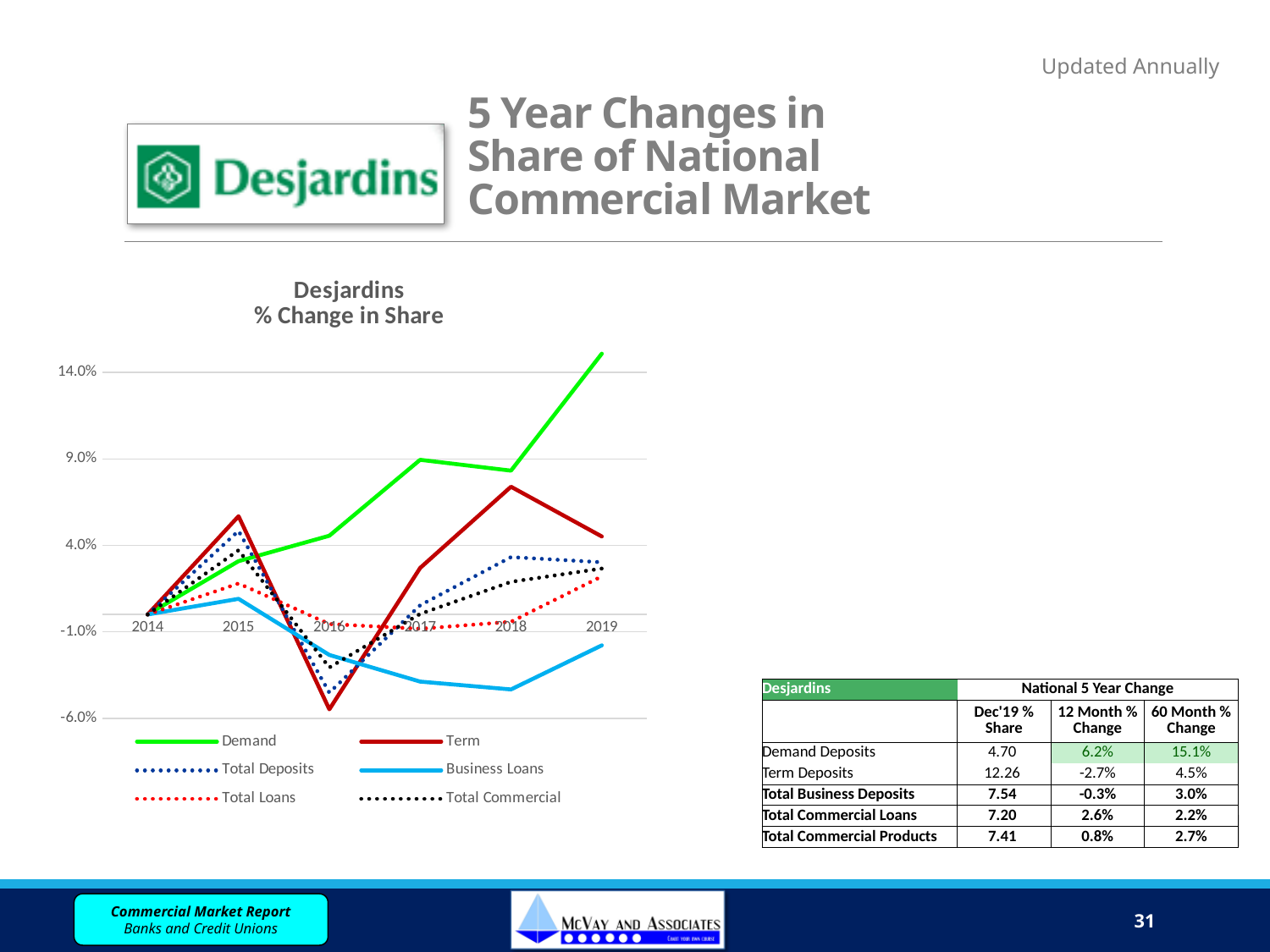
Which series has the lowest value in 2019? Business Loans Is the value for Term in 2016 greater or less than -1.0%? less What is the title of the chart? Desjardins % Change in Share How many series does the chart legend list? 6 Which series has the lowest value in 2016? Term What kind of chart is shown on the slide? line chart Which series has the highest value in 2019? Demand Which is larger in 2019, the value for Demand or the value for Term? Demand Is the value for Demand in 2017 greater or less than 4.0%? greater Is the value for Demand in 2019 greater or less than 14.0%? greater How many years are shown along the x axis of the chart? 6 Does the Demand series rise or fall from 2018 to 2019? rise